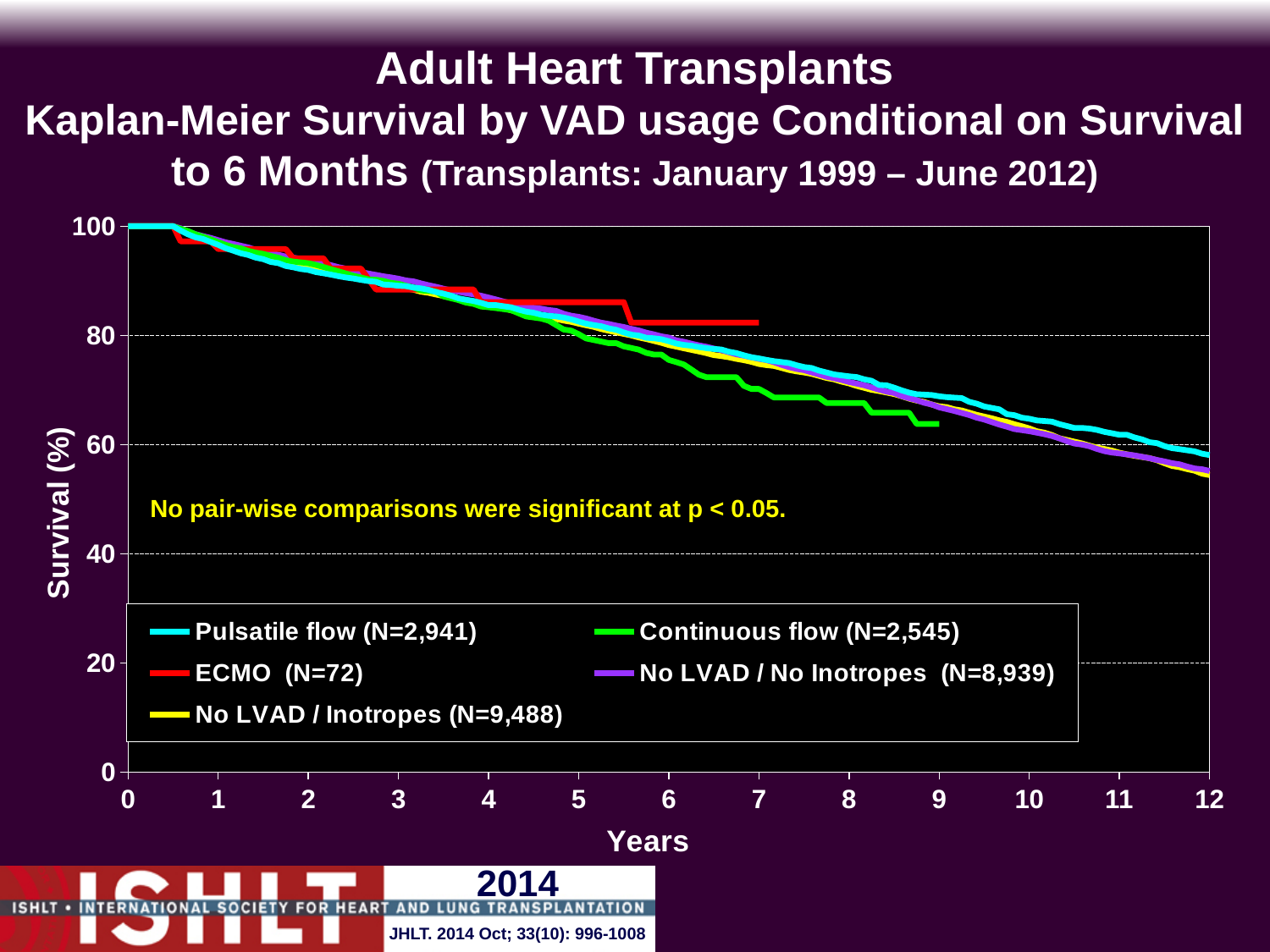
What kind of chart is shown on the slide? Line chart Which series has the lowest survival at 9 years? Continuous flow What does the yellow note on the chart say about pair-wise comparisons? No pair-wise comparisons were significant at p < 0.05. Is the survival value for No LVAD / Inotropes at 12 years greater or less than 60? less At 8 years, which has higher survival: Pulsatile flow or Continuous flow? Pulsatile flow Do the survival curves rise or fall as the years increase along the x axis? Fall Is the survival value for Continuous flow at 9 years greater or less than 60? greater At 6 years, which has higher survival: ECMO or Continuous flow? ECMO Is the survival value for ECMO at 7 years greater or less than 80? greater What is the N for the ECMO group shown in the legend? N=72 How many series does the legend list? 5